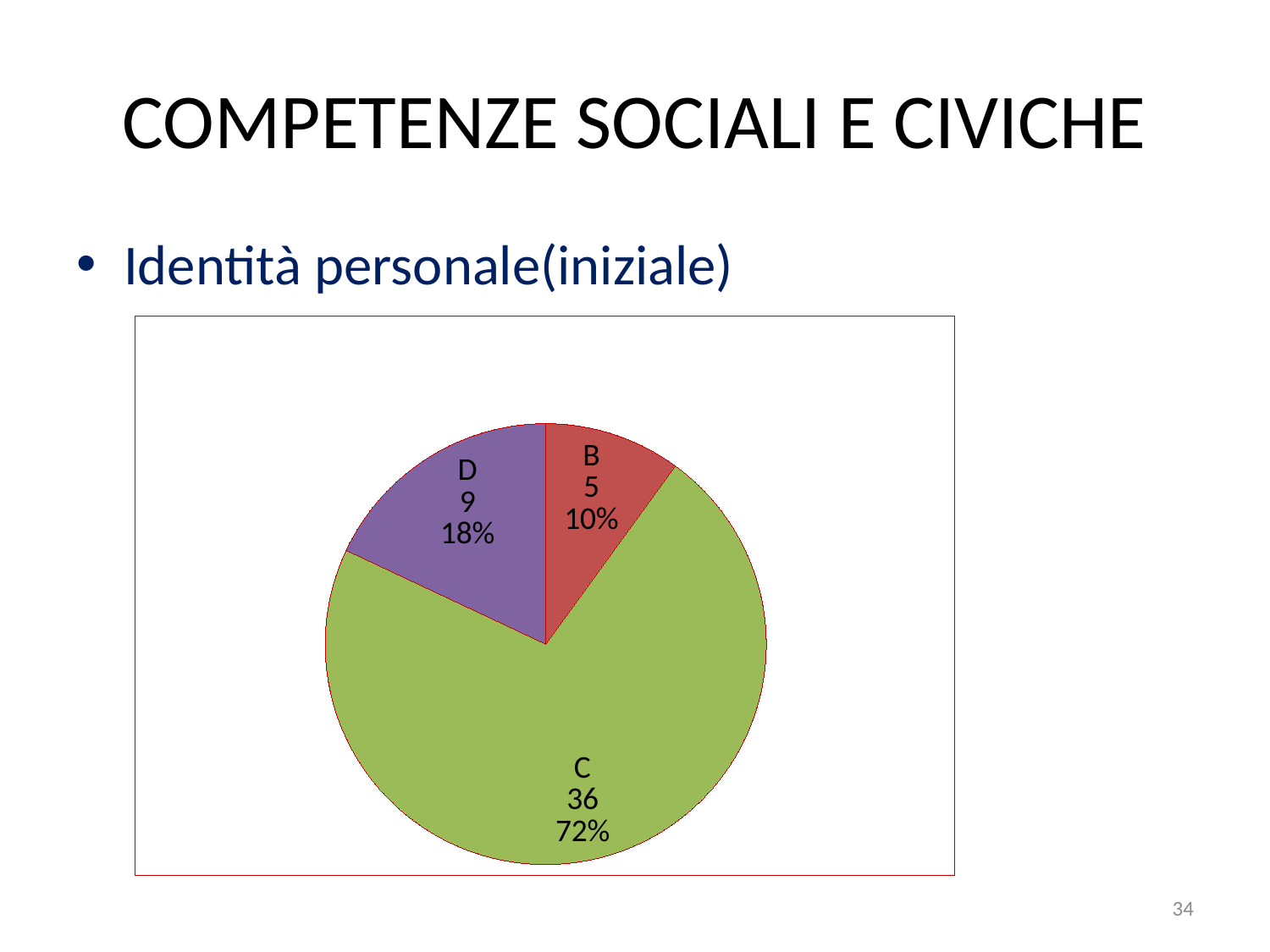
Which is larger, the value for D or the value for B? D What is the difference between the values for C and D? 27 What is the value for slice D? 9 What kind of chart is shown on the slide? pie chart Which slice is the largest? C What share of the pie does slice D represent? 18% What share of the pie does slice C represent? 72% How many slices does the pie chart have? 3 What is the value for slice B? 5 What share of the pie does slice B represent? 10% Which slice is the smallest? B What is the value for slice C? 36